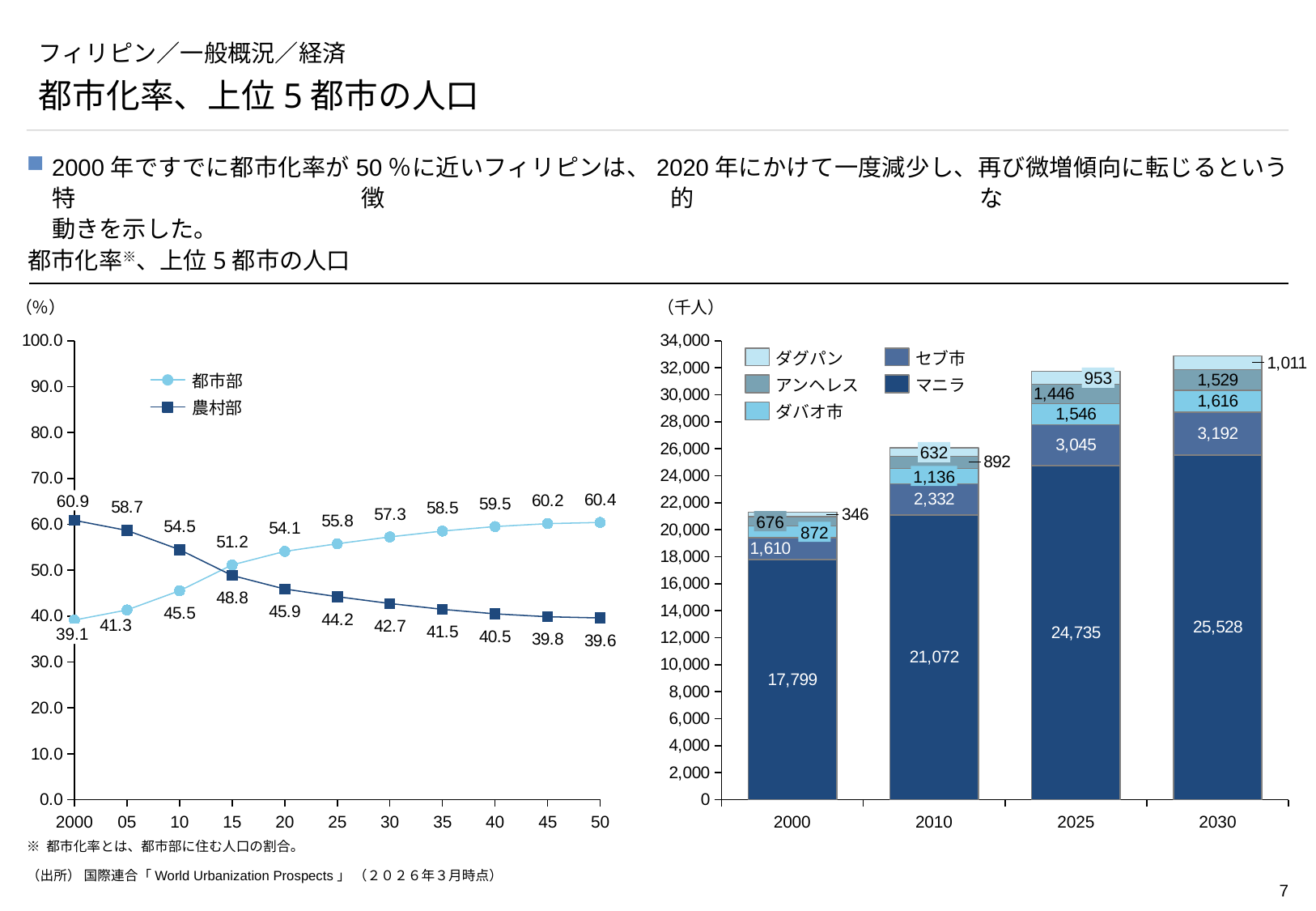
In the left line chart, what is the 農村部 value for 2015? 48.8 In the right bar chart, what is the difference between the セブ市 values for 2030 and 2010? 860 In the left line chart, what is the 都市部 value for 2000? 39.1 In the left line chart, what is the difference between the 都市部 and 農村部 values in 2050? 20.8 In the right bar chart, how many series does the legend list? 5 In the left line chart, does the 都市部 series rise or fall from 2000 to 2050? rise In the right bar chart, what is the total of the stacked bar for 2000? 21,303 What kind of chart is the chart on the right? stacked bar chart In the left line chart, which series has the higher value in 2010, 都市部 or 農村部? 農村部 In the right bar chart, what is the value for ダグパン in 2030? 1,011 In the left line chart, how many series does the legend list? 2 In the right bar chart, what is the value for マニラ in 2025? 24,735